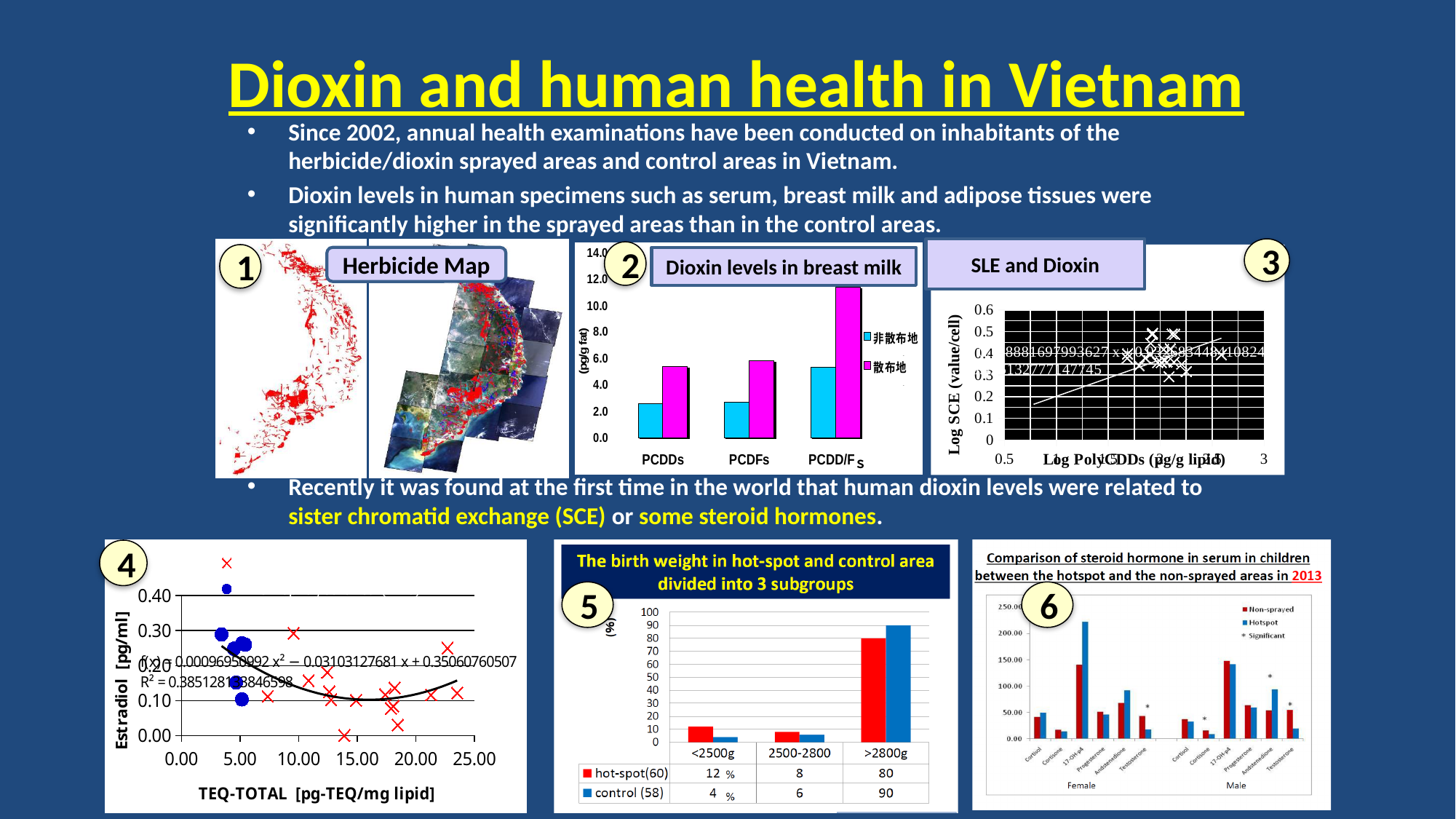
What kind of chart is chart 4 (Estradiol vs TEQ-TOTAL)? scatter plot In the 'Dioxin levels in breast milk' chart, how many series does the legend list? 2 In the steroid hormone comparison chart (chart 6), is the Hotspot value for 17-OH-p4 in females greater or less than 200.00? greater In the 'Dioxin levels in breast milk' chart, which category has the tallest bar? PCDD/Fs In the 'Dioxin levels in breast milk' chart, is the value of the cyan (非散布地) bar for PCDD/Fs greater or less than 4.0? greater In the 'Dioxin levels in breast milk' chart, how many categories are shown on the x axis? 3 In the birth weight chart (chart 5), what is the value for control (58) in the >2800g group? 90 In the 'Dioxin levels in breast milk' chart, is the value of the magenta (散布地) bar for PCDD/Fs greater or less than 10.0? greater In the birth weight chart (chart 5), which is larger in the 2500-2800 group, hot-spot(60) or control (58)? hot-spot(60) In the birth weight chart (chart 5), which group has the highest value for hot-spot(60)? >2800g In the birth weight chart (chart 5), what is the difference between the hot-spot(60) and control (58) values in the <2500g group? 8 In the birth weight chart (chart 5), what is the value for hot-spot(60) in the <2500g group? 12 %